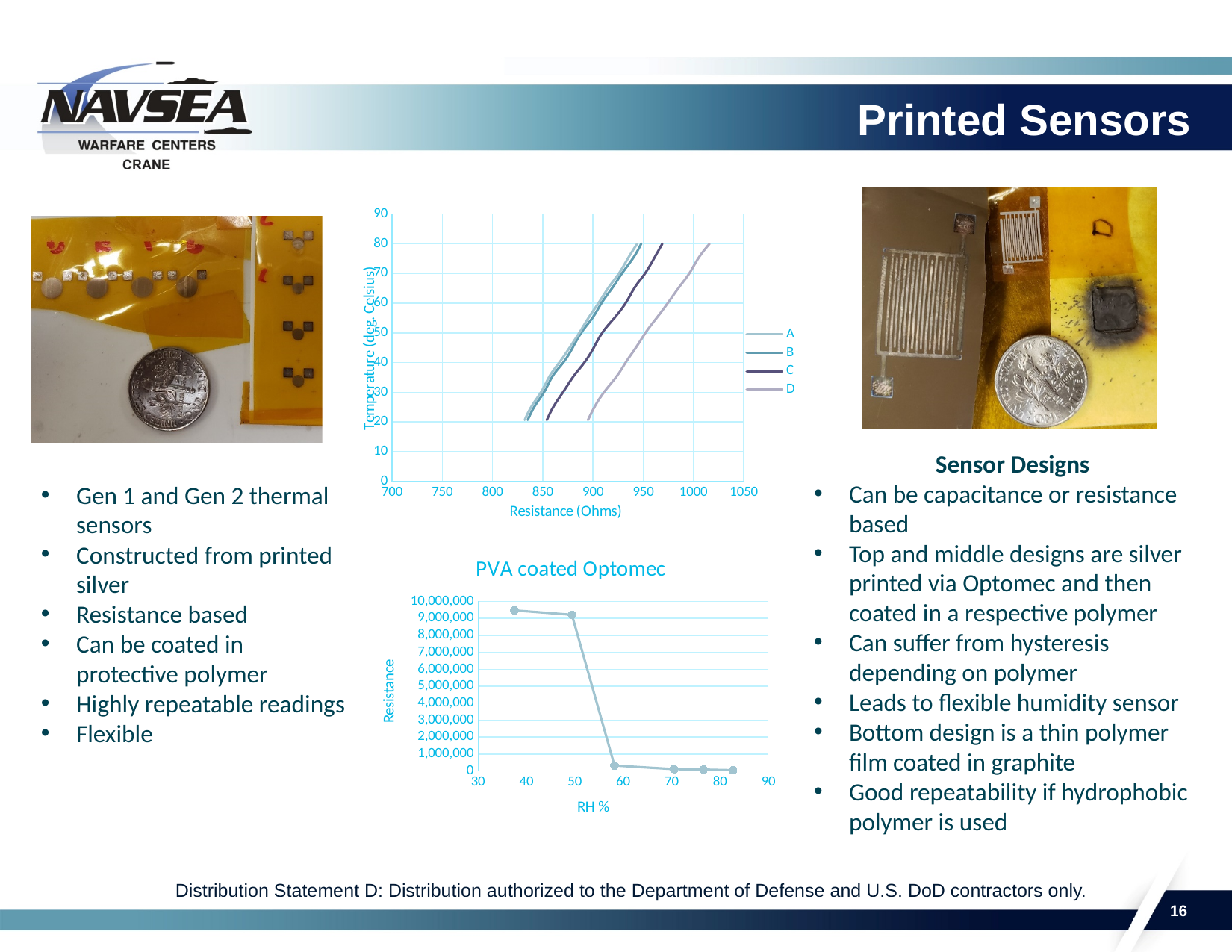
In the 'PVA coated Optomec' chart, does resistance rise or fall as RH % increases? fall In the top chart (Temperature vs Resistance), does temperature rise or fall as resistance increases? rise What is the x-axis label of the top chart (Temperature vs Resistance)? Resistance (Ohms) What is the title of the bottom chart? PVA coated Optomec In the 'PVA coated Optomec' chart, is the resistance at the lowest RH % point greater or less than 9,000,000? greater In the top chart (Temperature vs Resistance), what are the names of the series in the legend? A, B, C, D How many series does the legend of the top chart (Temperature vs Resistance) list? 4 In the top chart (Temperature vs Resistance), which series has the highest resistance at 80 degrees Celsius? D What type of chart is the top chart plotting Temperature against Resistance? line chart In the top chart (Temperature vs Resistance), is the resistance of series A at 20 degrees Celsius greater or less than 850 Ohms? less In the 'PVA coated Optomec' chart, is the resistance at about 70 RH % greater or less than 1,000,000? less